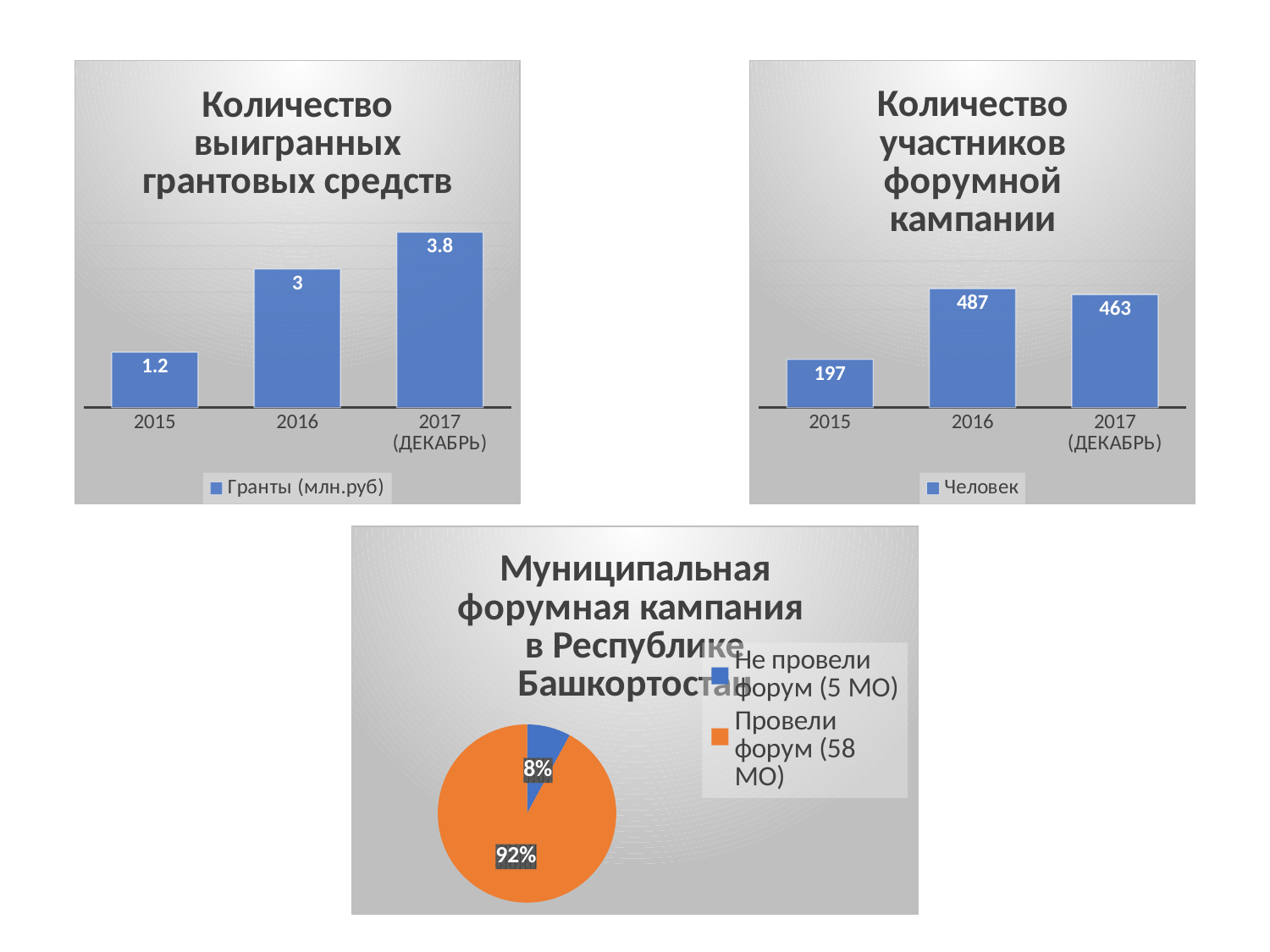
In the chart titled "Количество выигранных грантовых средств", what is the legend entry for the series? Гранты (млн.руб) In the chart titled "Количество выигранных грантовых средств", do the values rise or fall from 2015 to 2017 (ДЕКАБРЬ)? rise In the chart titled "Количество участников форумной кампании", what is the value for 2015? 197 In the chart titled "Количество выигранных грантовых средств", what is the difference between the 2017 (ДЕКАБРЬ) value and the 2015 value? 2.6 In the chart titled "Количество участников форумной кампании", how many years are shown on the x axis? 3 In the chart titled "Количество выигранных грантовых средств", which year has the highest value? 2017 (ДЕКАБРЬ) In the chart titled "Количество участников форумной кампании", which year has the lowest value? 2015 In the chart titled "Количество выигранных грантовых средств", what is the value for 2016? 3 In the chart titled "Количество участников форумной кампании", what is the difference between the 2016 value and the 2017 (ДЕКАБРЬ) value? 24 In the chart titled "Количество участников форумной кампании", which year has the highest value? 2016 What kind of chart is the one titled "Муниципальная форумная кампания в Республике Башкортостан"? pie chart In the pie chart titled "Муниципальная форумная кампания в Республике Башкортостан", what share is labelled for "Провели форум (58 МО)"? 92%